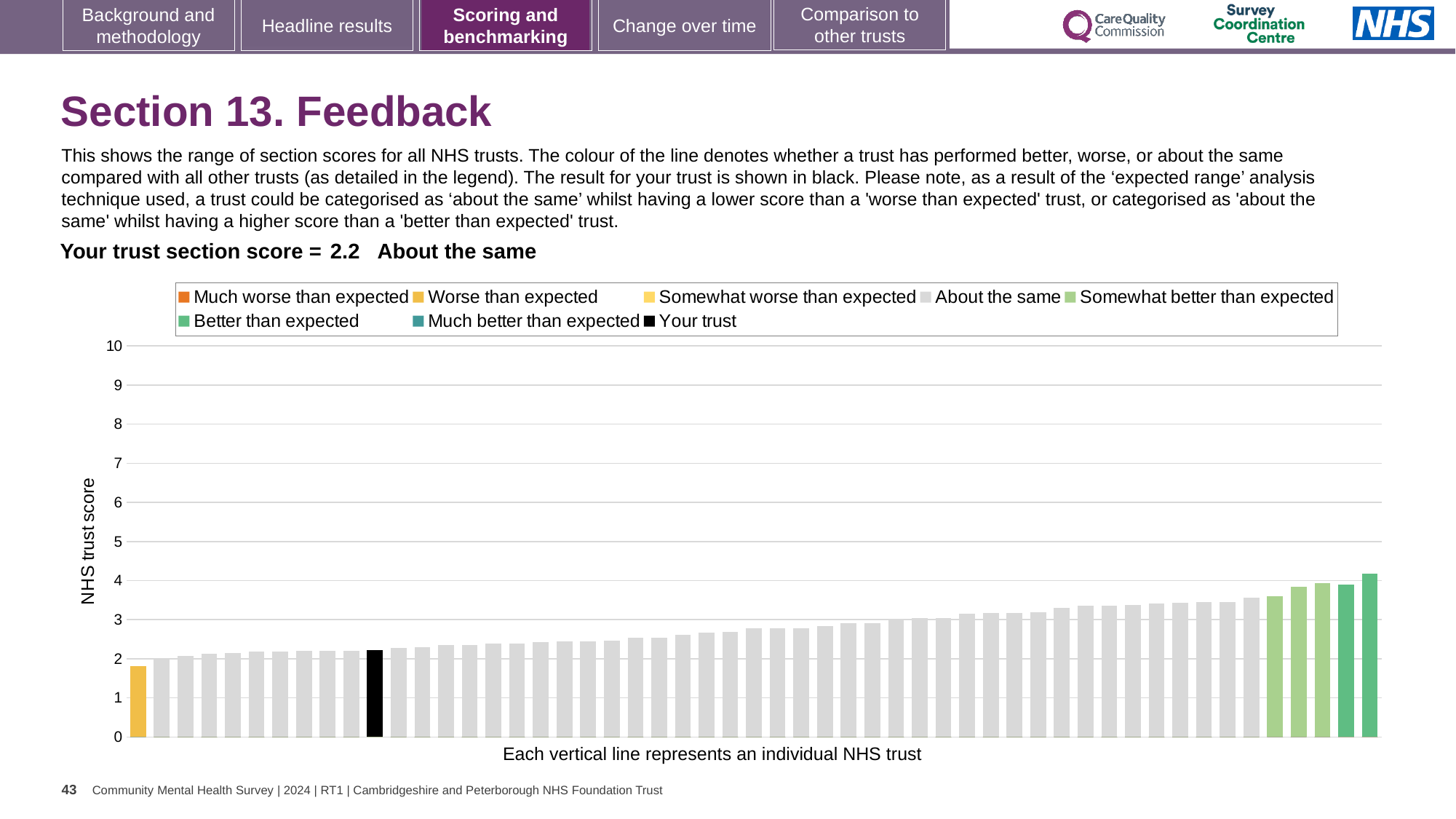
Which performance category is your trust placed in for Section 13. Feedback? About the same Do the trust scores rise or fall moving from left to right along the x axis? rise What is the section score for your trust shown on the chart? 2.2 What colour is used for the bar representing your trust? black What kind of chart is used to show the NHS trust section scores? bar chart Is the value of the lowest (leftmost) bar greater or less than 2? less Is the value of the highest (rightmost) bar greater or less than 5? less How many entries does the chart legend list? 8 Which is higher, the leftmost bar or the rightmost bar? the rightmost bar Is your trust's section score greater or less than 3? less What is the maximum value shown on the vertical axis? 10 What is the label on the vertical axis of the chart? NHS trust score